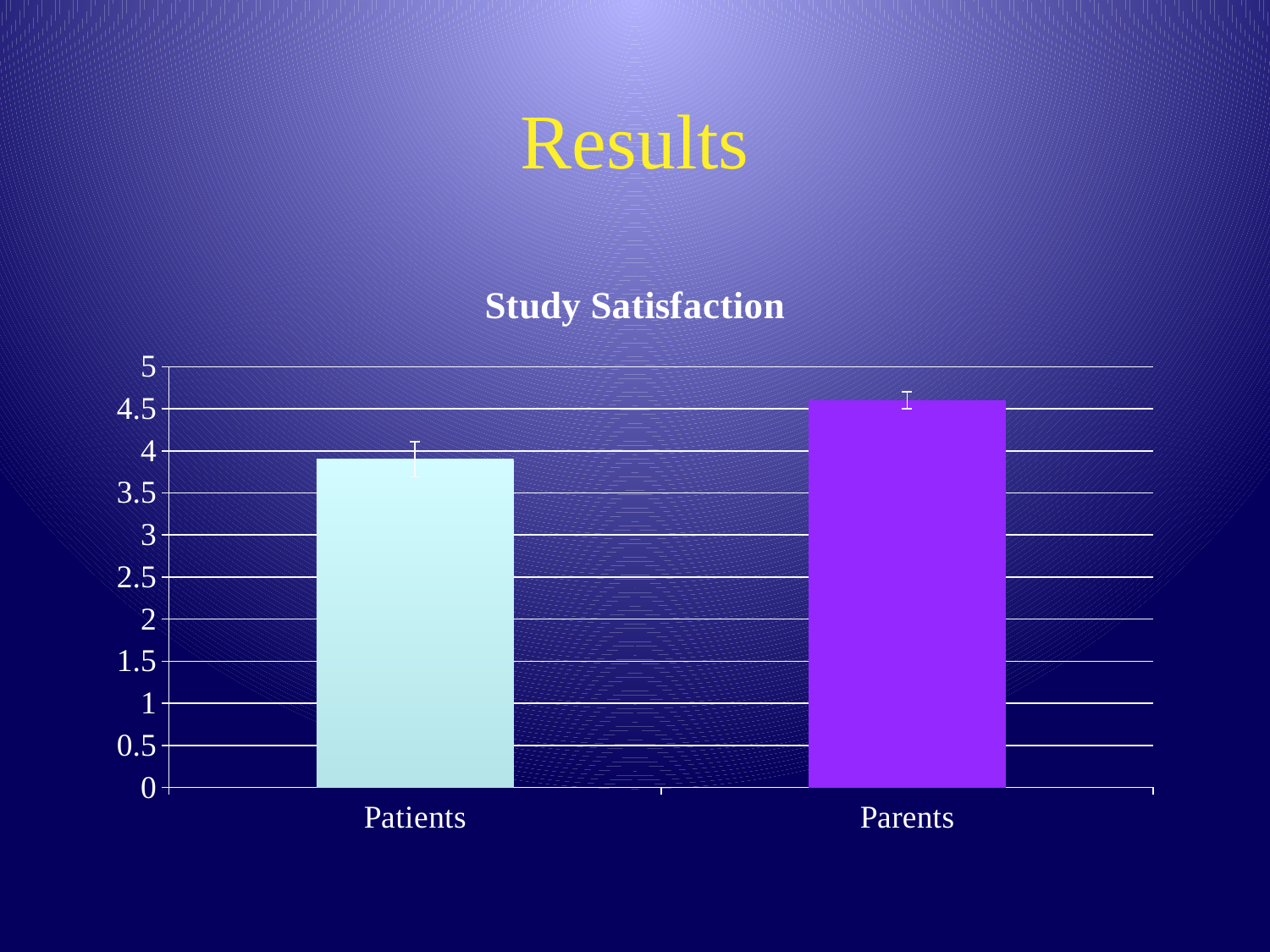
Which is larger, the value for Patients or the value for Parents? Parents Is the value for Patients greater or less than 4? less What is the title of the chart on the slide? Study Satisfaction Which category has the highest study satisfaction value? Parents How many categories are shown on the x axis of the Study Satisfaction chart? 2 Is the value for Patients greater or less than 3.5? greater Is the value for Parents greater or less than 4.5? greater Which category has the lowest study satisfaction value? Patients What kind of chart is shown under the title "Study Satisfaction"? bar chart What is the maximum value shown on the y axis of the chart? 5